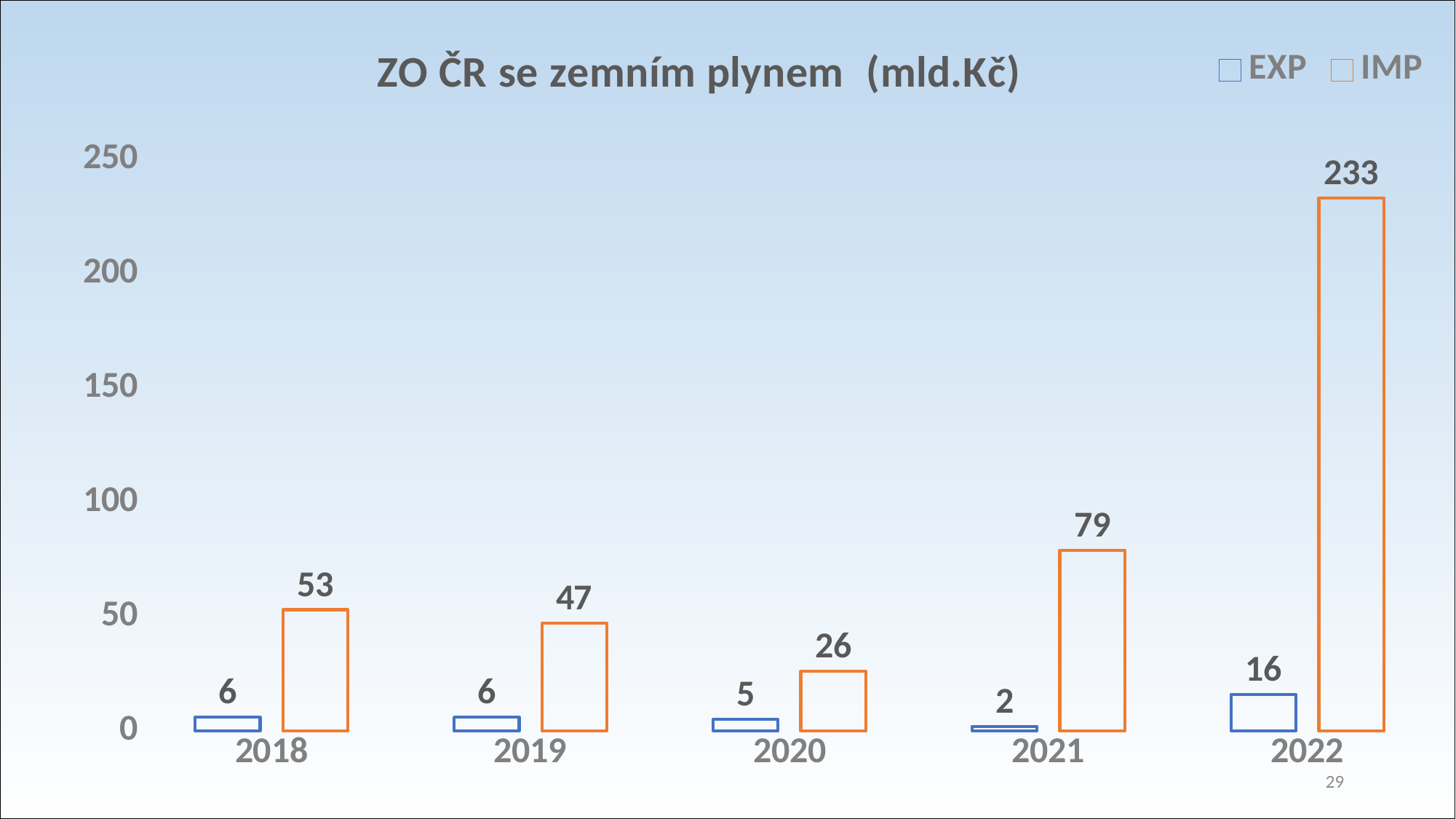
What kind of chart is shown on the slide? bar chart What is the IMP value for 2022? 233 Which year has the lowest IMP value? 2020 What is the EXP value for 2020? 5 Which year has the highest IMP value? 2022 What is the IMP value for 2019? 47 What is the difference between the IMP and EXP values in 2021? 77 How many years are shown on the x axis? 5 What is the title of the chart? ZO ČR se zemním plynem (mld.Kč) How many series does the legend list? 2 Which is larger, the IMP value for 2018 or the IMP value for 2019? 2018 Which year has the lowest EXP value? 2021